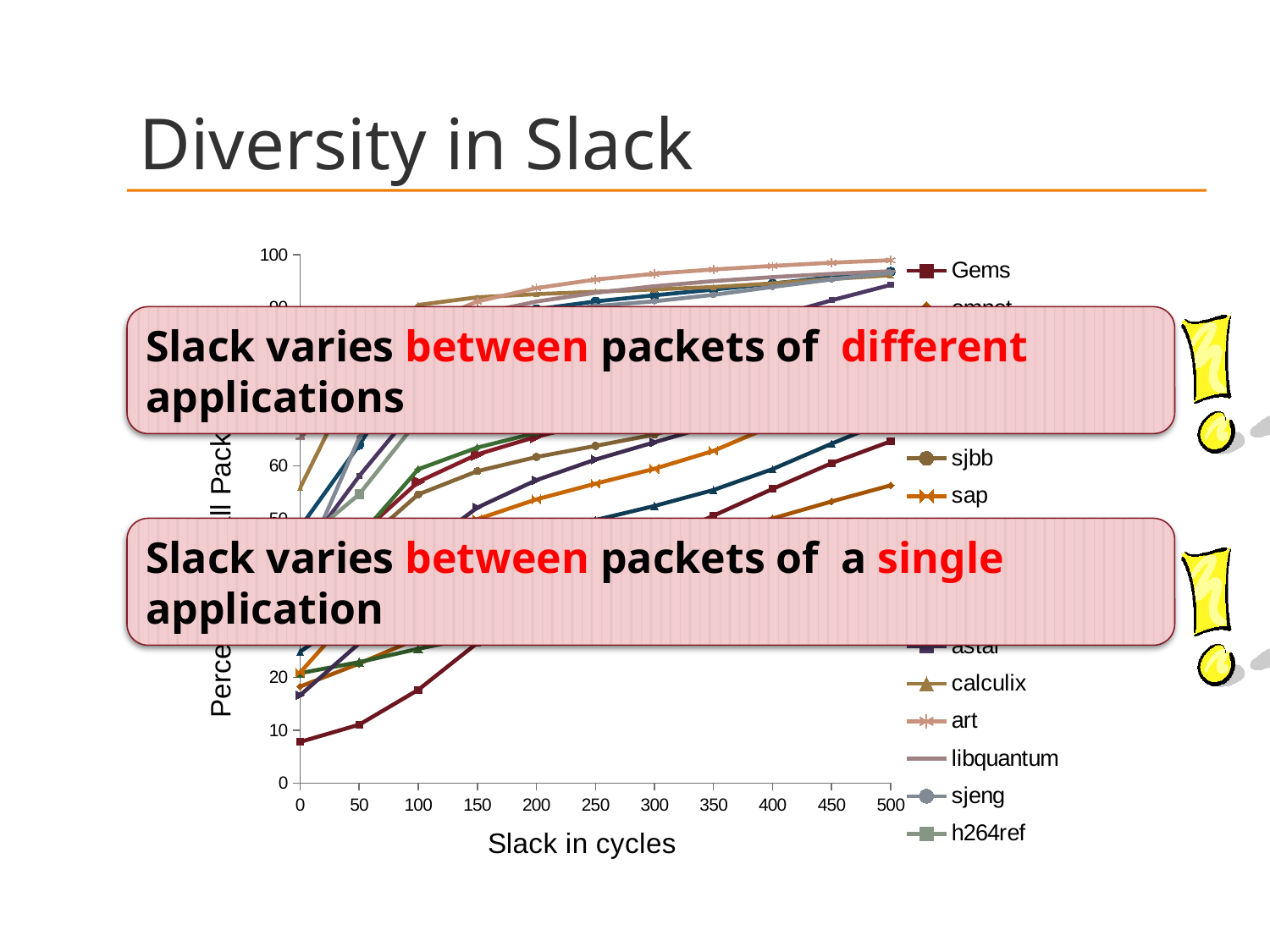
Which series has the lowest value at a slack of 0 cycles? Gems Is the value for Gems at a slack of 0 cycles greater or less than 10? less What is the x-axis title of the chart? Slack in cycles How many tick marks are labelled on the x axis of the chart? 11 What is the last legend entry listed for the chart? h264ref Is the value for Gems at a slack of 100 cycles greater or less than 20? less Is the value for art at a slack of 500 cycles greater or less than 90? greater Do the plotted lines rise or fall as slack in cycles increases? rise What kind of chart is shown on the slide? line chart At a slack of 500 cycles, which is higher: art or Gems? art